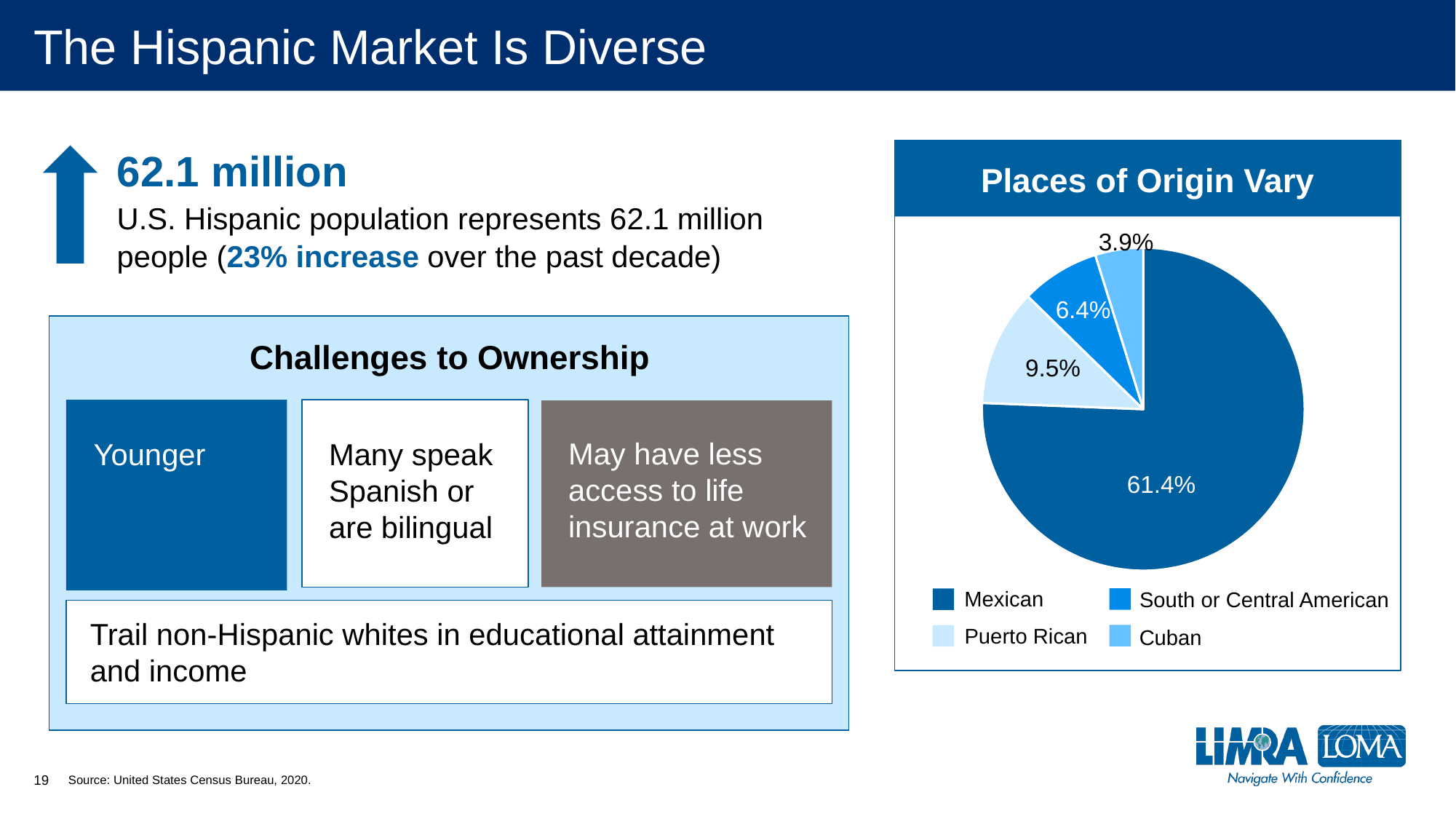
What percentage of the pie chart is labelled for Mexican? 61.4% Which place of origin has the largest slice in the pie chart? Mexican How many entries does the pie chart's legend list? 4 What percentage does the pie chart show for Cuban? 3.9% What is the title of the pie chart? Places of Origin Vary Which slice is larger in the pie chart, Puerto Rican or Cuban? Puerto Rican What kind of chart is shown under the title "Places of Origin Vary"? pie chart Which place of origin has the smallest slice in the pie chart? Cuban How many slices does the pie chart have? 4 What percentage does the pie chart show for South or Central American? 6.4% What percentage does the pie chart show for Puerto Rican? 9.5% What is the difference in percentage points between the Mexican and Puerto Rican slices? 51.9